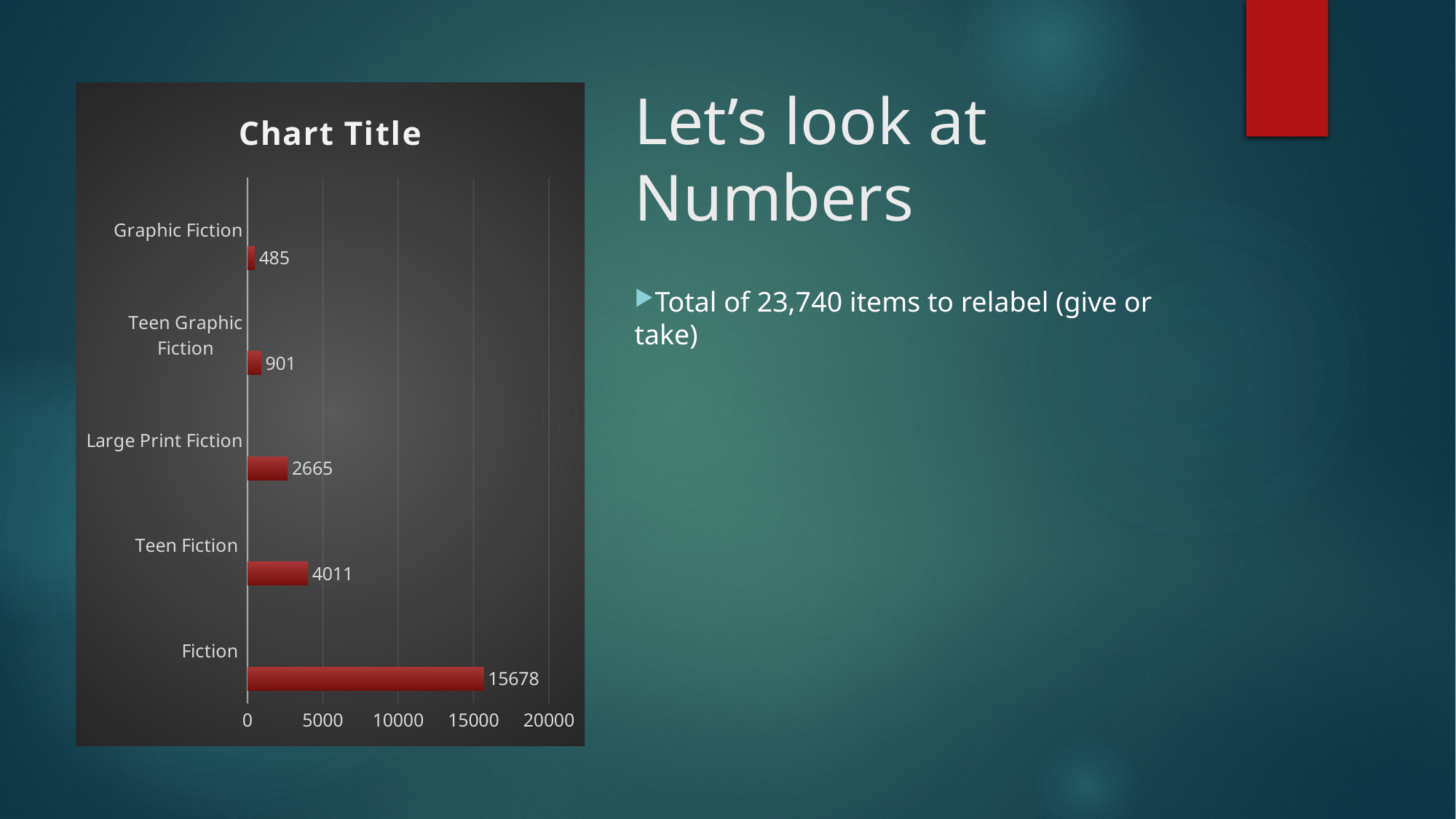
Which category has the lowest value? Graphic Fiction How many categories are shown in the chart? 5 What is the value for Large Print Fiction? 2665 Which is larger, the value for Large Print Fiction or the value for Teen Graphic Fiction? Large Print Fiction What is the difference between the values for Fiction and Teen Fiction? 11667 What is the value for Fiction? 15678 Is the value for Fiction greater or less than 15000? greater Which category has the highest value? Fiction What is the value for Graphic Fiction? 485 What kind of chart is shown on the slide? bar chart What is the value for Teen Fiction? 4011 What is the value for Teen Graphic Fiction? 901